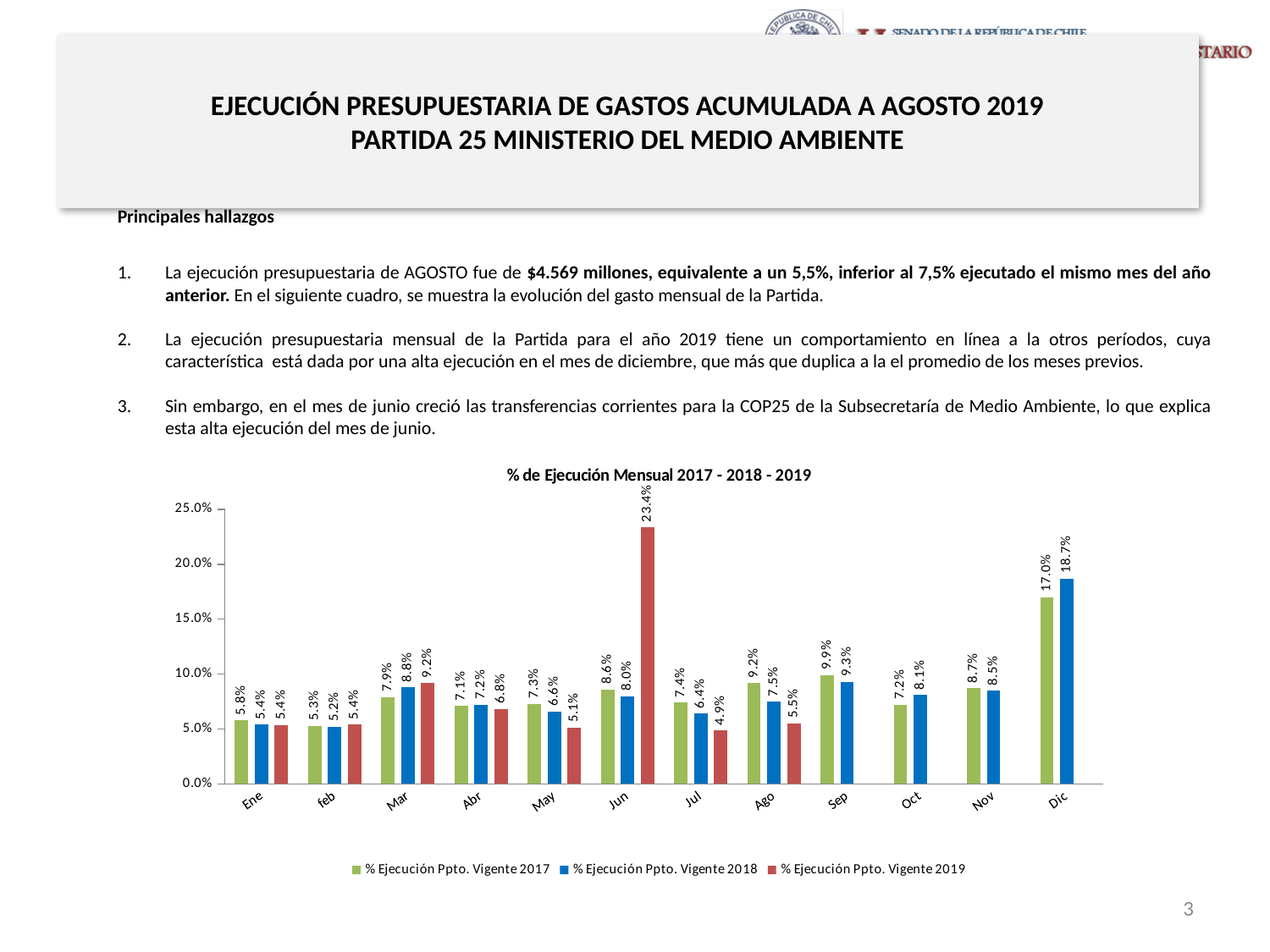
What is the title of the chart? % de Ejecución Mensual 2017 - 2018 - 2019 How many months are shown on the x axis? 12 Is the value for % Ejecución Ppto. Vigente 2019 in Jun greater or less than 20.0%? greater What is the value for % Ejecución Ppto. Vigente 2019 in Jun? 23.4% What is the value for % Ejecución Ppto. Vigente 2017 in Ago? 9.2% Which is larger in Mar: the 2017 value or the 2019 value? 2019 value Which month has the highest value for % Ejecución Ppto. Vigente 2019? Jun How many series does the legend list? 3 Which month has the lowest value for % Ejecución Ppto. Vigente 2019? Jul What is the difference between the 2018 and 2017 values in Dic? 1.7% What kind of chart is shown on the slide? Bar chart What is the value for % Ejecución Ppto. Vigente 2018 in Dic? 18.7%